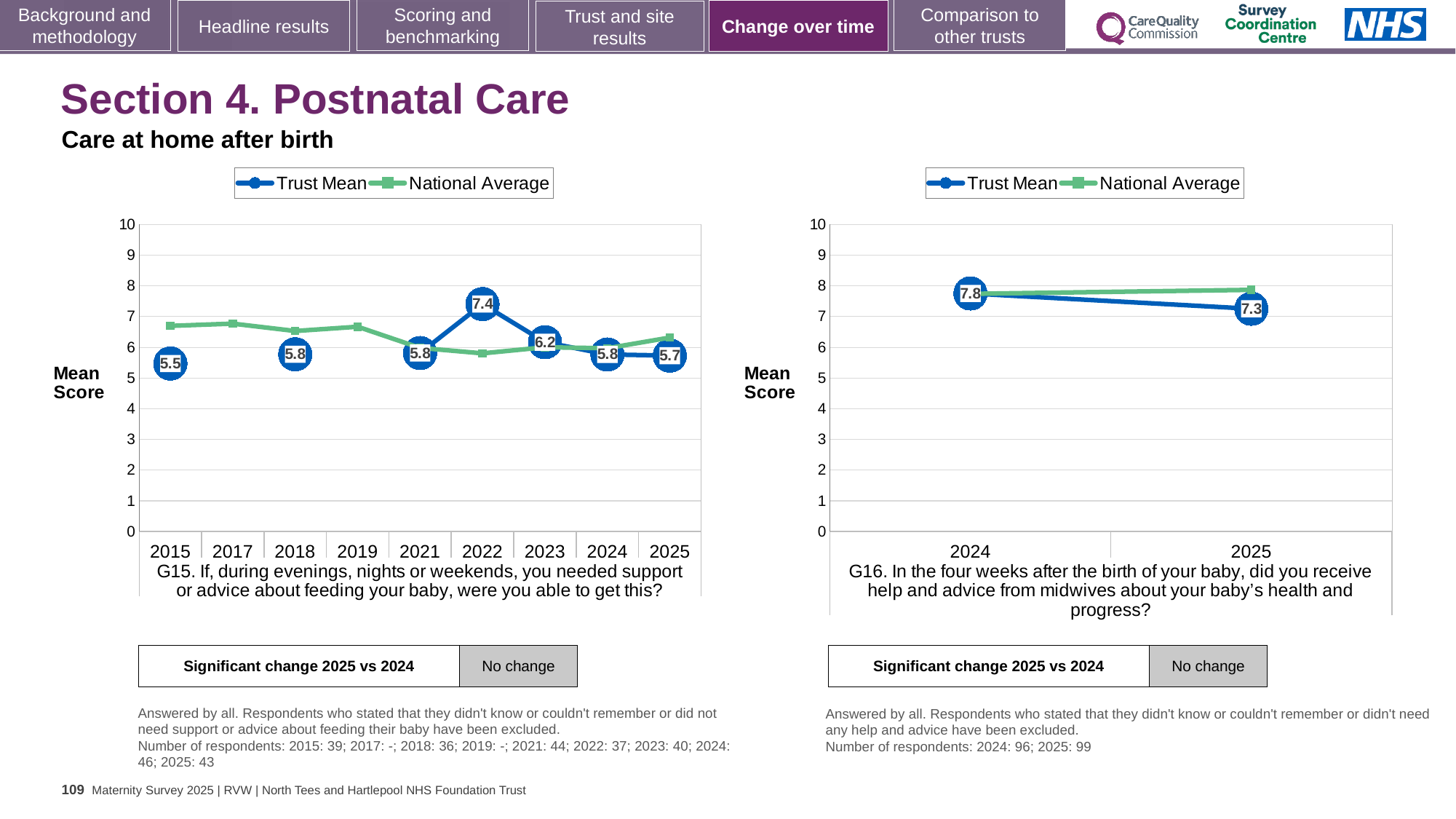
In the G15 chart on the left, which year has the highest Trust Mean? 2022 In the G16 chart on the right, what is the Trust Mean for 2024? 7.8 In the G15 chart on the left, how many years are shown on the x axis? 9 What kind of chart is the G16 chart on the right? line chart In the G15 chart on the left, what is the Trust Mean for 2022? 7.4 In the G15 chart on the left, what is the Trust Mean for 2015? 5.5 In the G15 chart on the left, which year has the lowest Trust Mean? 2015 In the G15 chart on the left, is the National Average for 2015 greater or less than 6? greater In the G16 chart on the right, does the Trust Mean rise or fall from 2024 to 2025? fall In the G16 chart on the right, what is the Trust Mean for 2025? 7.3 In the G16 chart on the right, how many series does the legend list? 2 In the G15 chart on the left, what is the difference between the Trust Mean for 2022 and the Trust Mean for 2023? 1.2